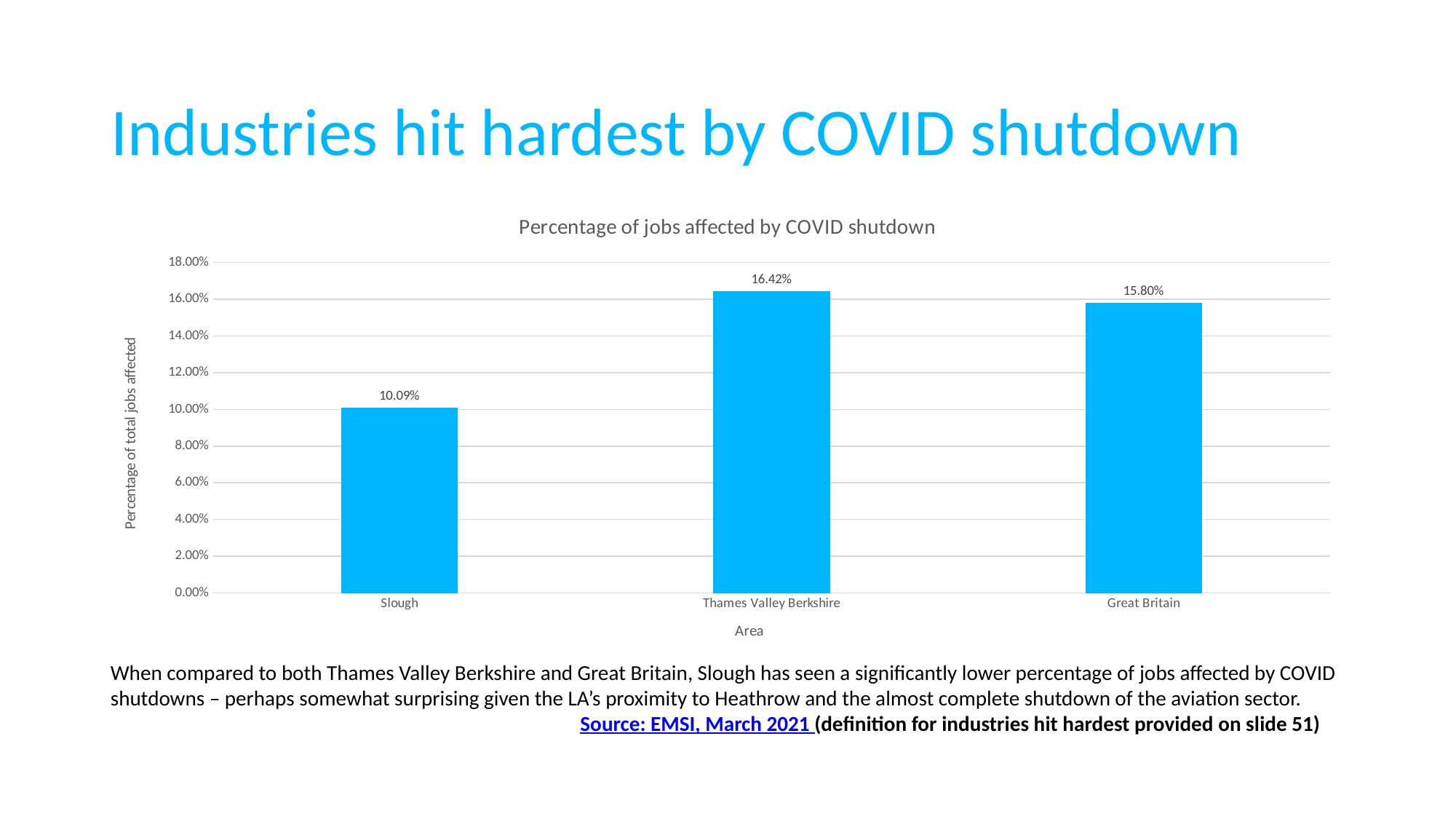
What is the percentage of jobs affected by COVID shutdown for Great Britain? 15.80% Which area has the lowest percentage of jobs affected by COVID shutdown? Slough What is the difference in percentage points between Thames Valley Berkshire and Great Britain? 0.62% What is the difference in percentage points between Thames Valley Berkshire and Slough? 6.33% Which has a higher percentage of jobs affected: Great Britain or Slough? Great Britain What type of chart is shown on the slide? Bar chart Is the value for Slough greater or less than 12.00%? less What is the title of the chart? Percentage of jobs affected by COVID shutdown Which area has the highest percentage of jobs affected by COVID shutdown? Thames Valley Berkshire How many areas are shown in the chart? 3 What is the percentage of jobs affected by COVID shutdown for Thames Valley Berkshire? 16.42% What is the percentage of jobs affected by COVID shutdown for Slough? 10.09%